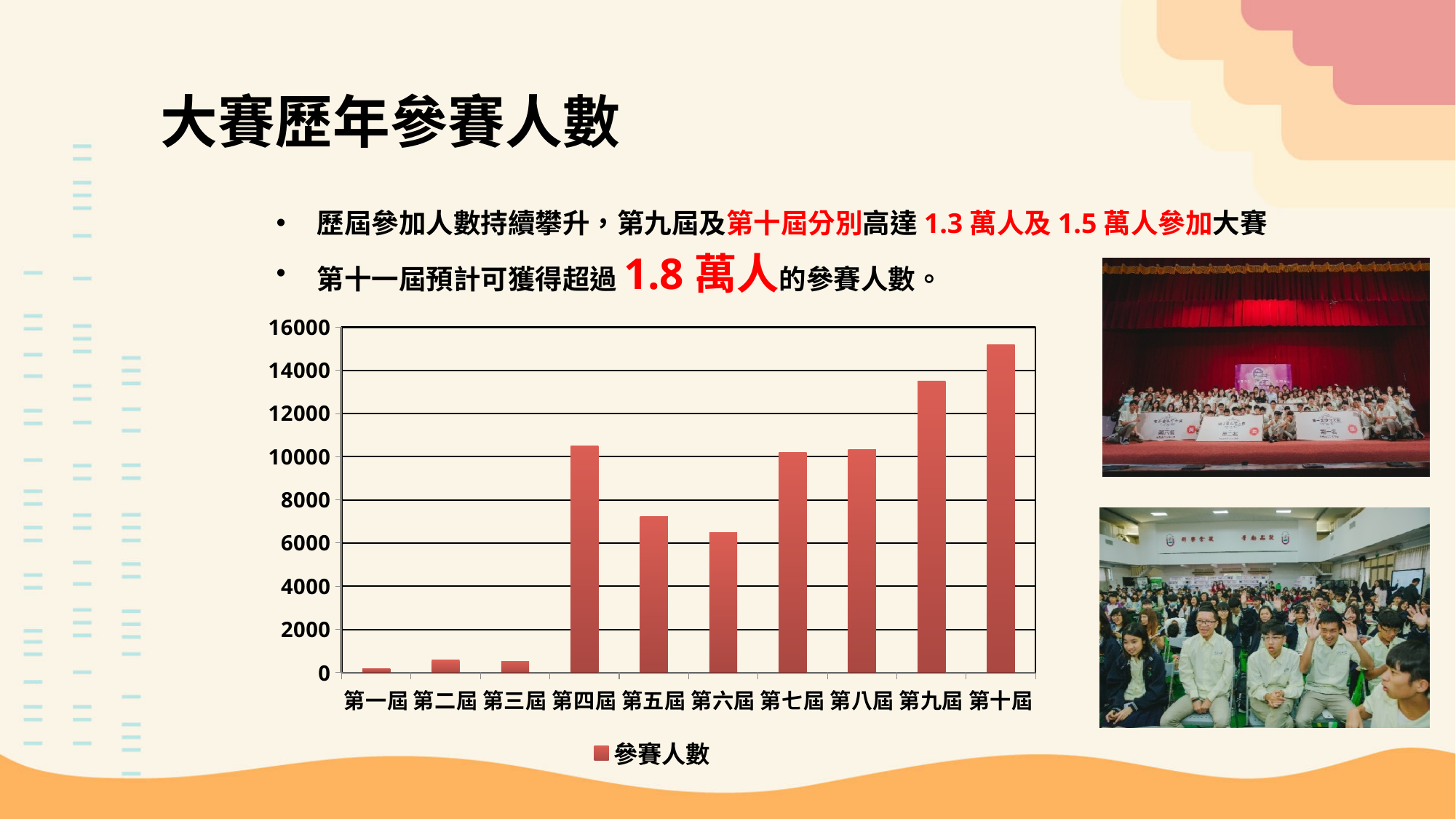
How many categories (屆) are shown on the x axis of the chart? 10 Overall, do the values rise or fall from 第一屆 to 第十屆? rise How many series does the chart legend list? 1 Is the value for 第九屆 greater or less than 12000? greater Is the value for 第十屆 greater or less than 14000? greater What kind of chart is shown on the slide? bar chart Is the value for 第五屆 greater or less than 8000? less What is the name of the series shown in the chart legend? 參賽人數 Which category has the lowest value in the chart? 第一屆 Which has a larger value, 第四屆 or 第五屆? 第四屆 Which category has the highest value in the chart? 第十屆 Which has a larger value, 第九屆 or 第十屆? 第十屆